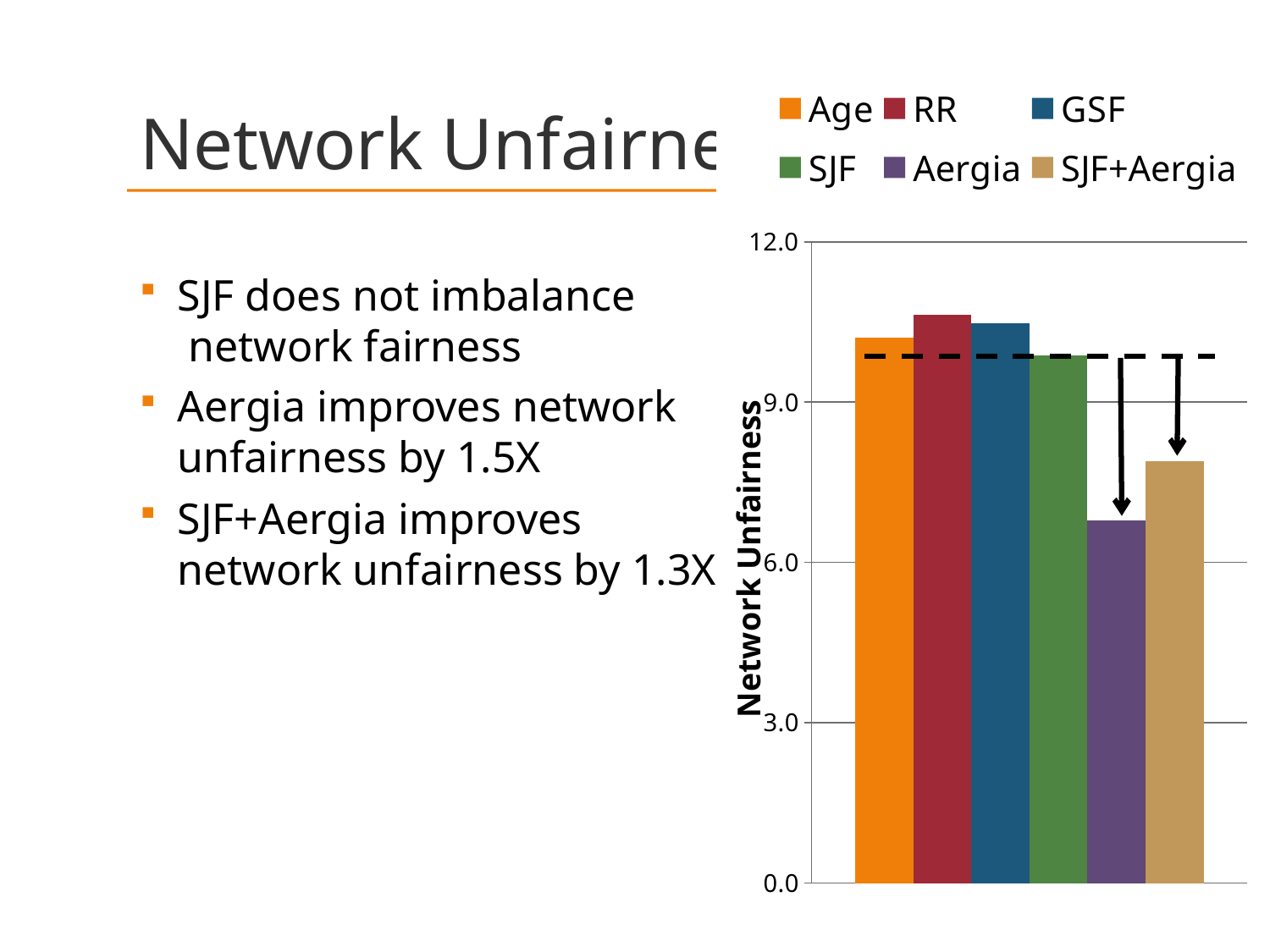
Is the Network Unfairness value for Aergia greater or less than 6.0? greater Which has the larger Network Unfairness value, SJF or SJF+Aergia? SJF What kind of chart is shown on the slide? bar chart How many series does the chart's legend list? 6 Which has the larger Network Unfairness value, Age or Aergia? Age What is the title of the chart's vertical axis? Network Unfairness Which series has the lowest Network Unfairness value? Aergia Is the Network Unfairness value for Aergia greater or less than 9.0? less Is the Network Unfairness value for SJF+Aergia greater or less than 9.0? less Which series is shown in purple in the chart's legend? Aergia Which has the larger Network Unfairness value, Aergia or SJF+Aergia? SJF+Aergia